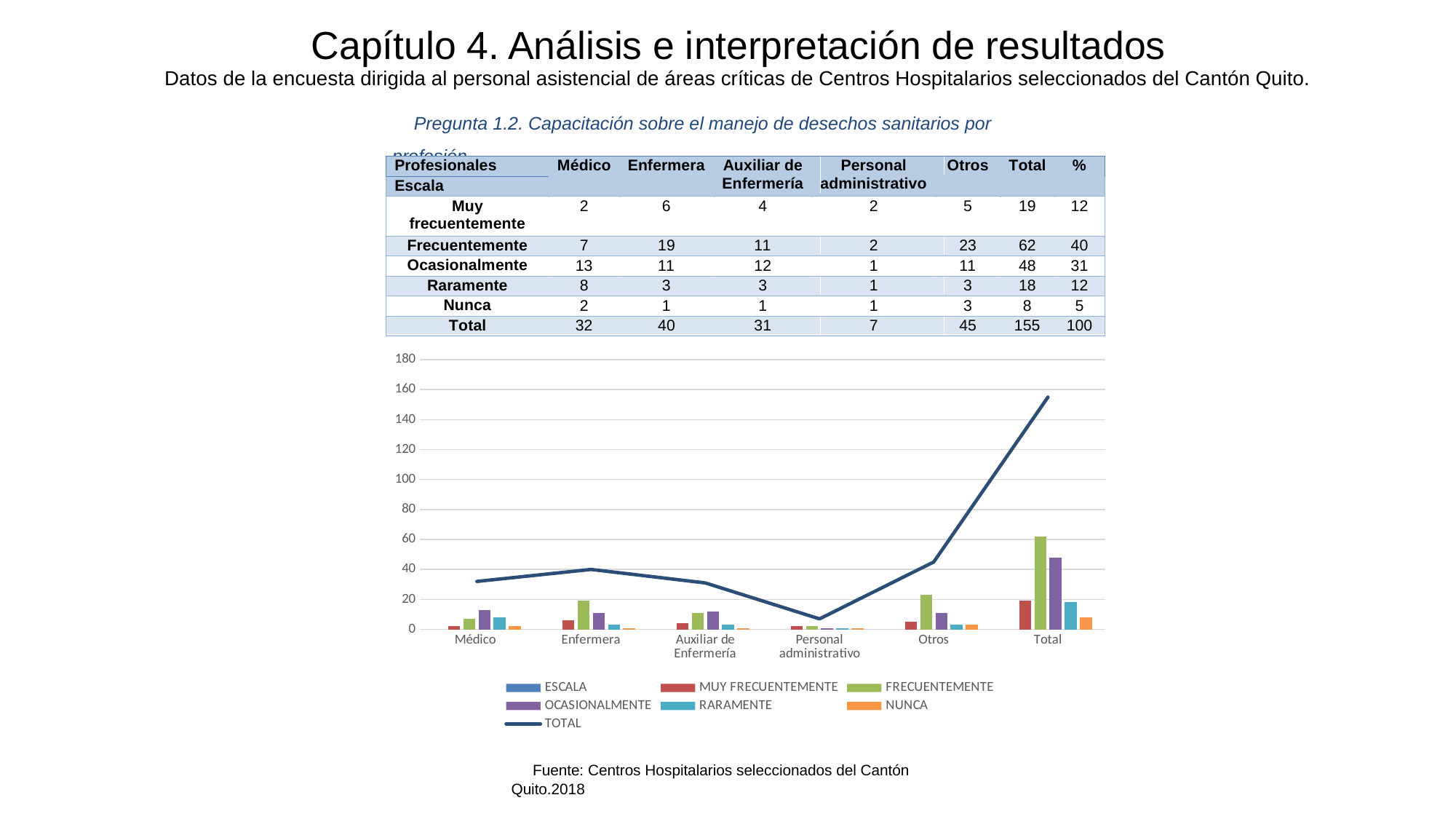
What is the value of the TOTAL line at the Total category? 155 What colour is the TOTAL series drawn in on the chart? Dark blue Which category has the lowest value on the TOTAL line? Personal administrativo Excluding the Total category, which profession has the highest value on the TOTAL line? Otros How many categories are shown along the x axis of the chart? 6 Is the TOTAL line value for Otros greater or less than 60? less How many series does the chart legend list? 7 Is the TOTAL line value at the Total category greater or less than 140? greater Which has the larger FRECUENTEMENTE bar, Médico or Enfermera? Enfermera Does the TOTAL line rise or fall from Personal administrativo to Total? It rises What is the difference between the TOTAL line values for Enfermera and Médico? 8 What kind of chart is shown on the slide? A combination bar and line chart